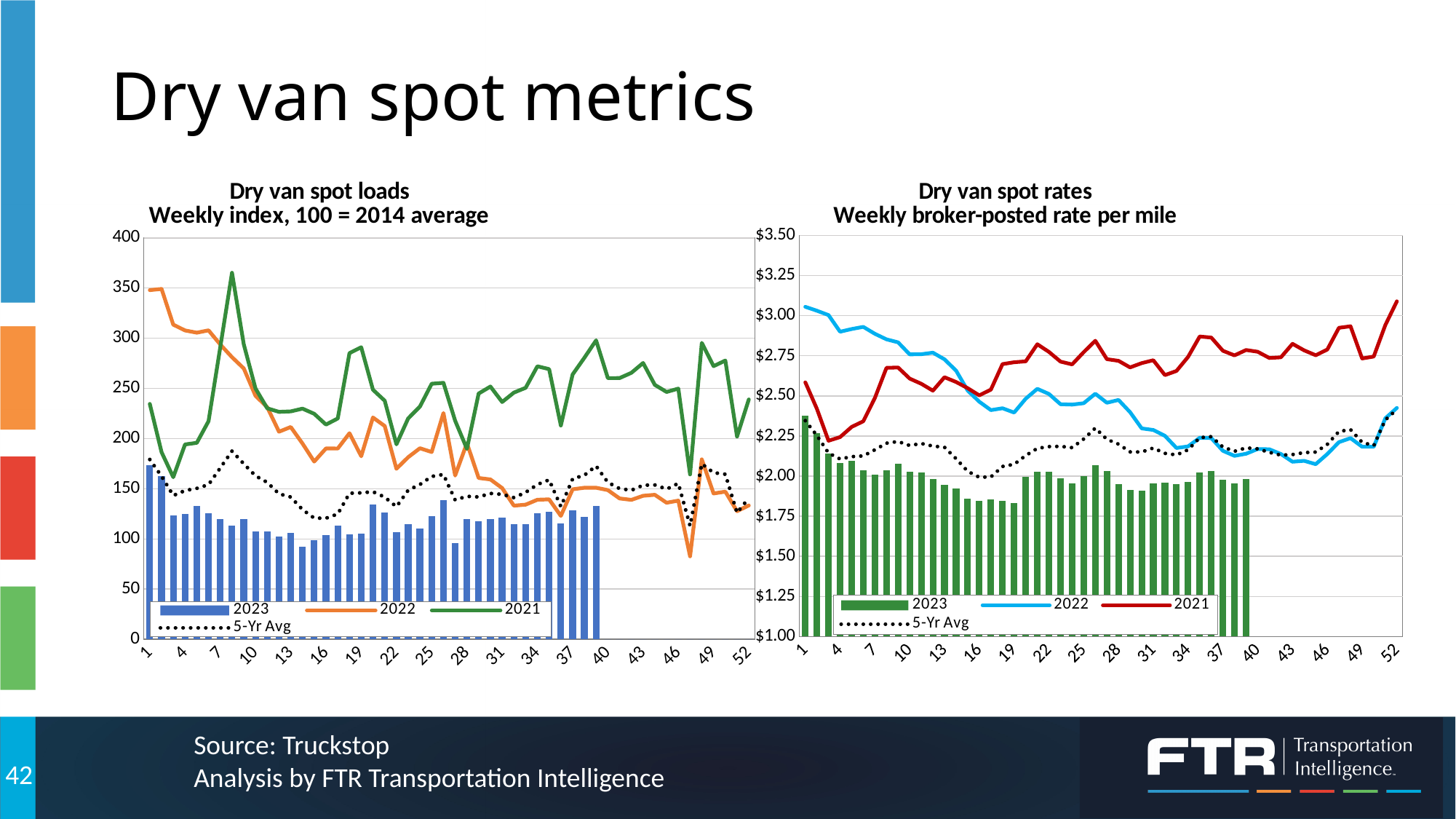
On the 'Dry van spot loads' chart, at week 1, which is higher: the 2022 line or the 2021 line? 2022 On the 'Dry van spot rates' chart, at week 52, which is higher: the 2021 line or the 2022 line? 2021 On the 'Dry van spot rates' chart, is the 2022 value at week 1 greater or less than $3.00? greater On the 'Dry van spot loads' chart, which series is drawn as bars rather than a line? 2023 On the 'Dry van spot rates' chart, does the 2022 line generally rise or fall from week 1 to week 52? fall On the 'Dry van spot rates' chart, is the 2021 value at week 52 greater or less than $3.00? greater On the 'Dry van spot loads' chart, is the 2022 value at week 1 greater or less than 300? greater On the 'Dry van spot rates' chart, how many series does the legend list? 4 On the 'Dry van spot loads' chart, does the 2022 line generally rise or fall from week 1 to week 52? fall On the 'Dry van spot loads' chart, how many series does the legend list? 4 On the 'Dry van spot rates' chart, what is the subtitle shown under the chart title? Weekly broker-posted rate per mile